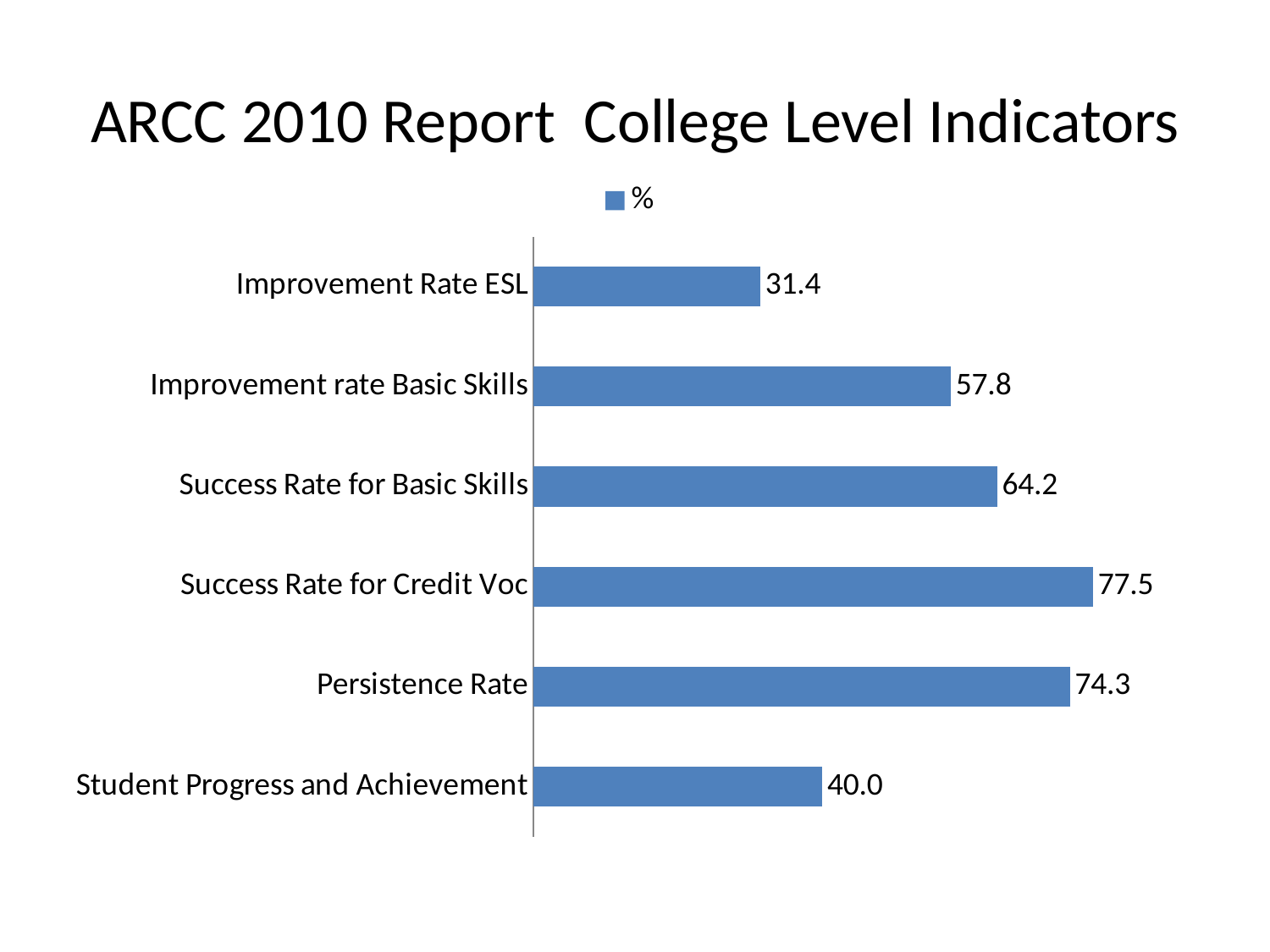
What is the value for Persistence Rate? 74.3 How many series does the legend list? 1 What is the title of the slide? ARCC 2010 Report College Level Indicators Which category has the lowest value? Improvement Rate ESL How many categories are shown in the chart? 6 Which is larger, Persistence Rate or Student Progress and Achievement? Persistence Rate What is the value for Improvement Rate ESL? 31.4 What is the value for Success Rate for Credit Voc? 77.5 What is the difference between Success Rate for Basic Skills and Improvement rate Basic Skills? 6.4 Which category has the highest value? Success Rate for Credit Voc What kind of chart is shown on the slide? Bar chart What is the value for Student Progress and Achievement? 40.0